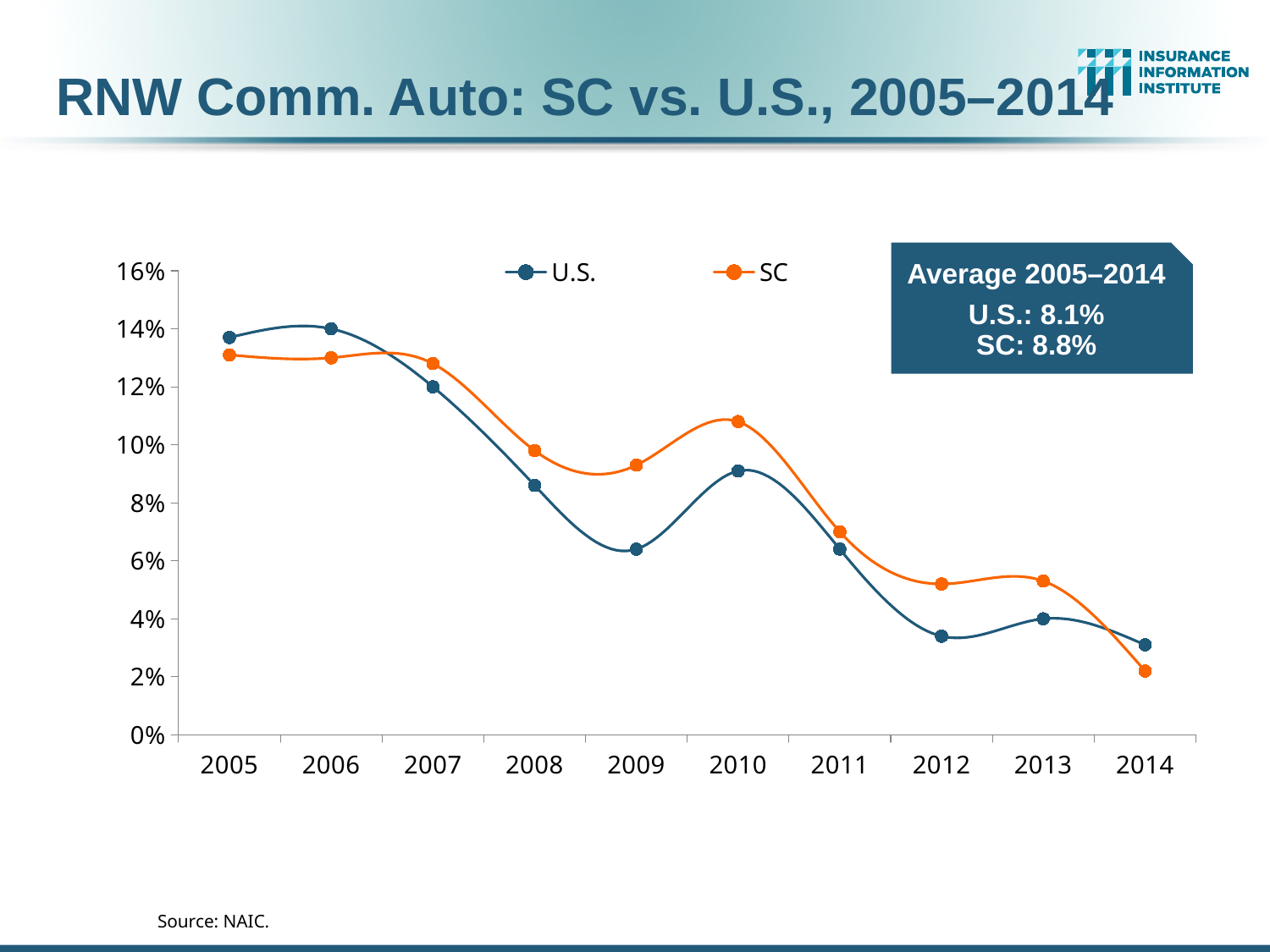
What kind of chart is shown on the slide? Line chart How many years are plotted along the x axis? 10 Is the U.S. value for 2009 greater or less than 8%? less In which year is the SC value lowest? 2014 Overall, do the values for SC rise or fall from 2005 to 2014? Fall Is the SC value for 2014 greater or less than 4%? less How many series does the legend list? 2 In 2014, which series has the larger value, U.S. or SC? U.S. According to the text box, what is the U.S. average for 2005–2014? 8.1% Is the SC value for 2010 greater or less than 10%? greater In 2010, which series has the larger value, U.S. or SC? SC According to the text box, what is the SC average for 2005–2014? 8.8%